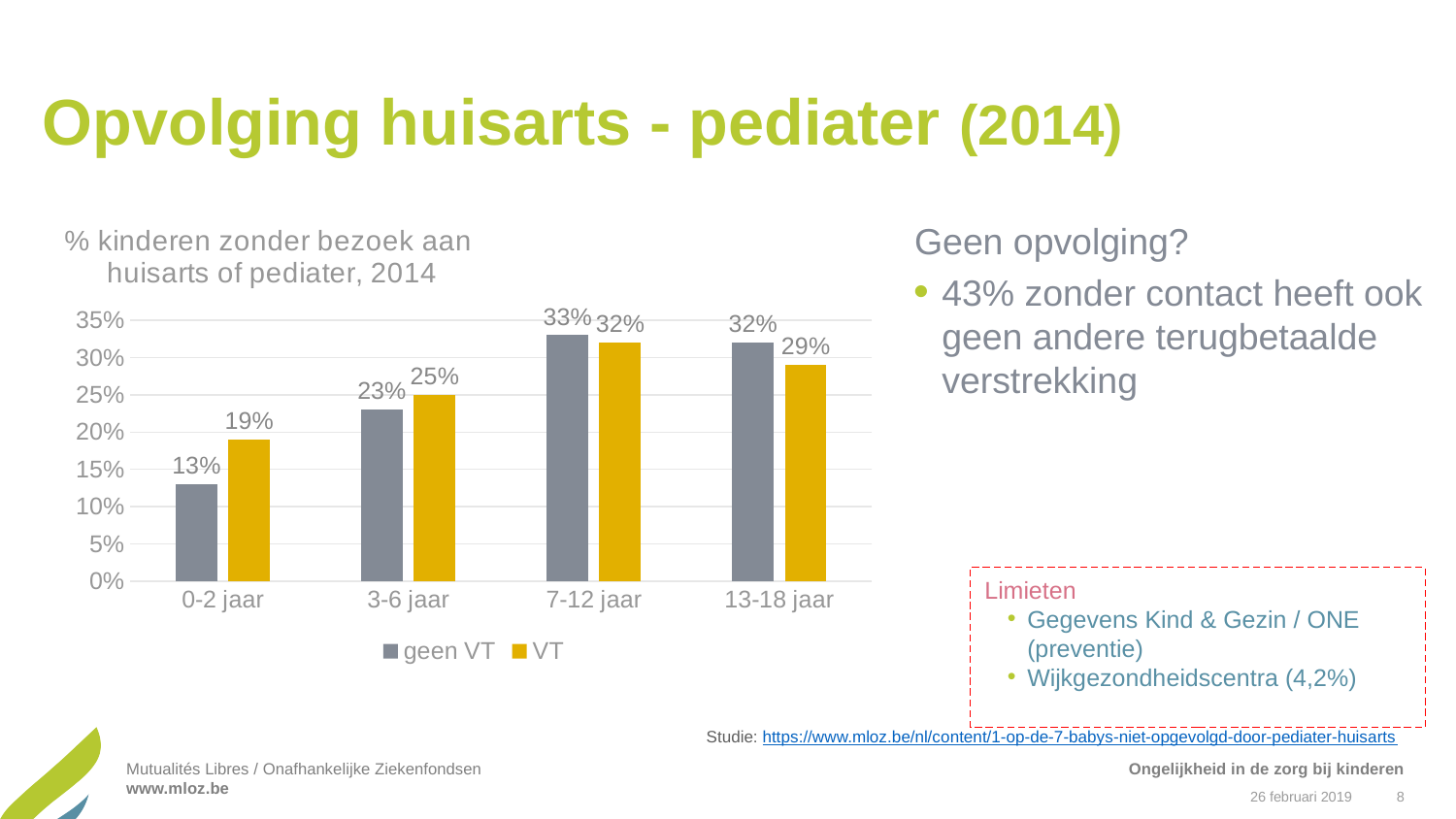
How many series does the legend list? 2 What is the value for 'VT' in the 3-6 jaar category? 25% What is the difference between the 'VT' and 'geen VT' values in the 0-2 jaar category? 6% Which age category has the highest 'geen VT' value? 7-12 jaar What is the value for 'VT' in the 13-18 jaar category? 29% Which colour represents the 'VT' series? yellow What is the title of the chart? % kinderen zonder bezoek aan huisarts of pediater, 2014 Which age category has the lowest 'VT' value? 0-2 jaar How many age categories are shown on the x axis? 4 What kind of chart is shown on the slide? bar chart In the 13-18 jaar category, which is larger: 'geen VT' or 'VT'? geen VT What is the value for 'geen VT' in the 0-2 jaar category? 13%